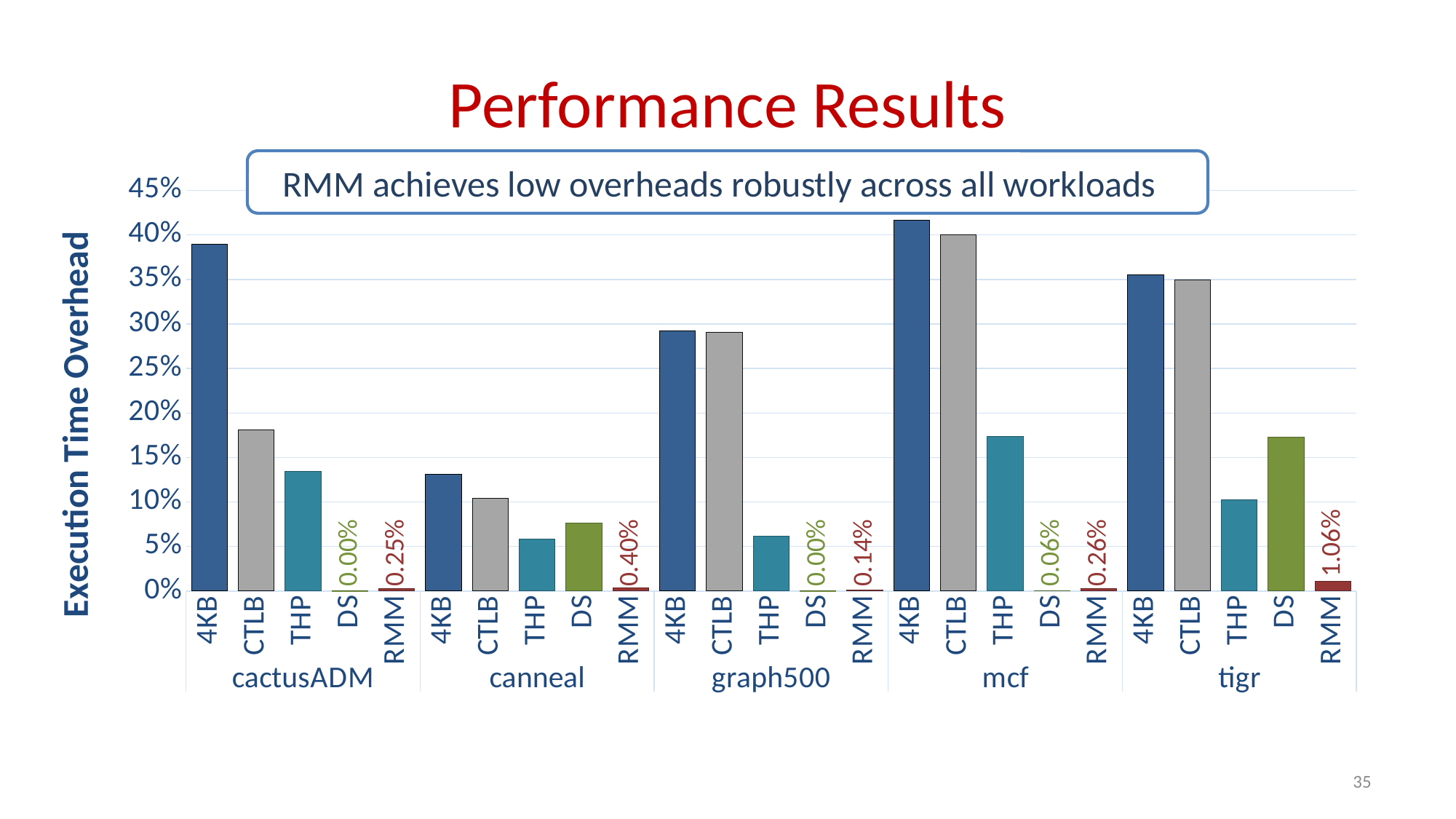
Which workload has the highest RMM execution time overhead? tigr How many workloads are shown on the x axis of the chart? 5 What is the label of the y axis of the chart? Execution Time Overhead Is the execution time overhead for 4KB on mcf greater or less than 40%? greater What is the execution time overhead for RMM on the graph500 workload? 0.14% What is the execution time overhead for RMM on the tigr workload? 1.06% What is the execution time overhead for DS on the mcf workload? 0.06% What is the execution time overhead for DS on the cactusADM workload? 0.00% What is the difference between the RMM overhead on mcf and the DS overhead on mcf? 0.20% Which is larger: the RMM overhead on canneal or the RMM overhead on cactusADM? RMM on canneal Which workload has the lowest RMM execution time overhead? graph500 Is the execution time overhead for THP on canneal greater or less than 10%? less